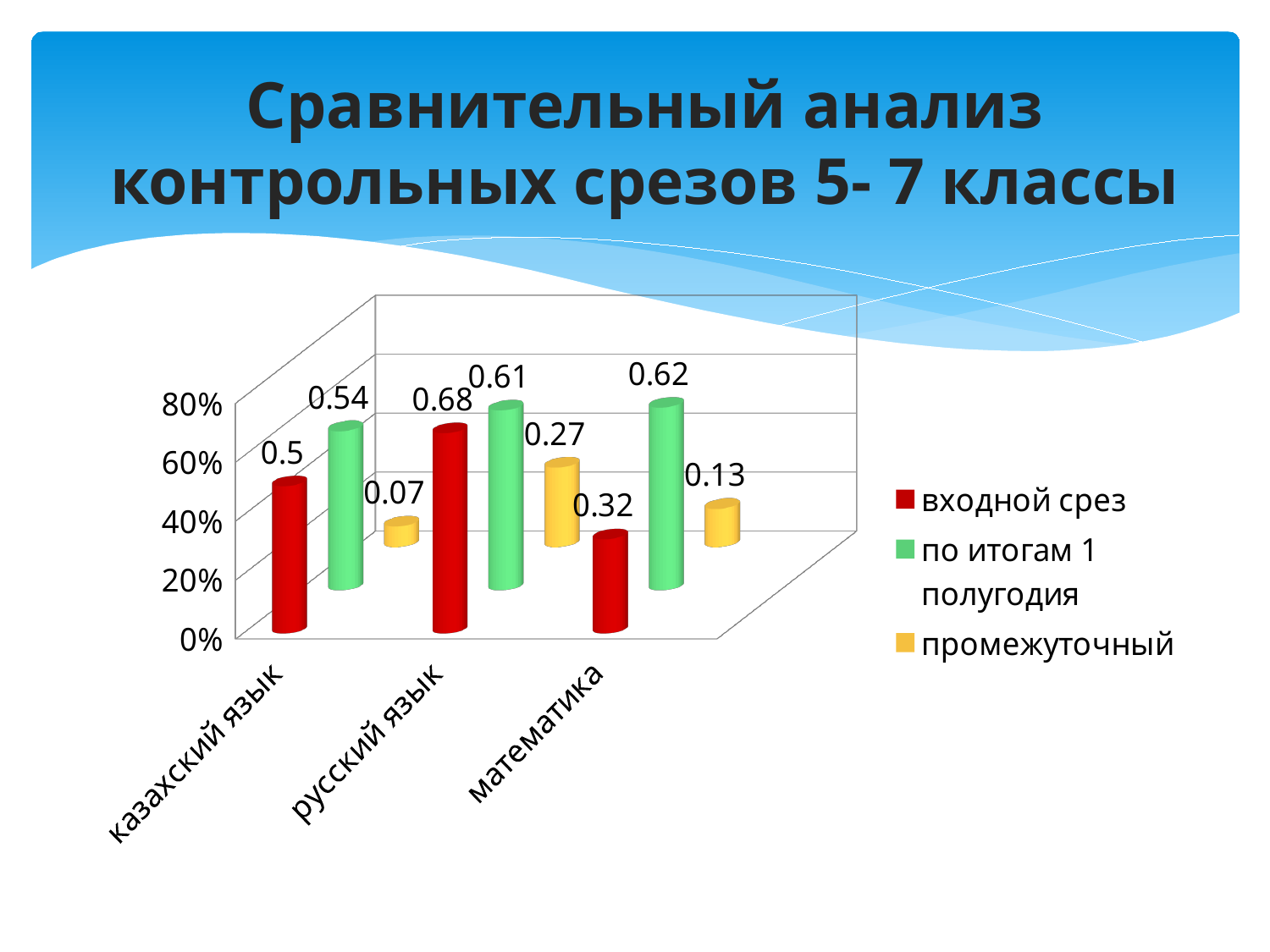
Which is larger for казахский язык: входной срез or по итогам 1 полугодия? по итогам 1 полугодия What kind of chart is shown on the slide? bar chart Which colour represents the промежуточный series? yellow What is the value for входной срез for математика? 0.32 What is the value for по итогам 1 полугодия for математика? 0.62 Which category has the lowest value for промежуточный? казахский язык Which category has the highest value for входной срез? русский язык What is the value for входной срез for казахский язык? 0.5 What is the value for промежуточный for русский язык? 0.27 What is the difference between the входной срез values for русский язык and математика? 0.36 How many series does the legend list? 3 How many categories are shown on the x axis? 3